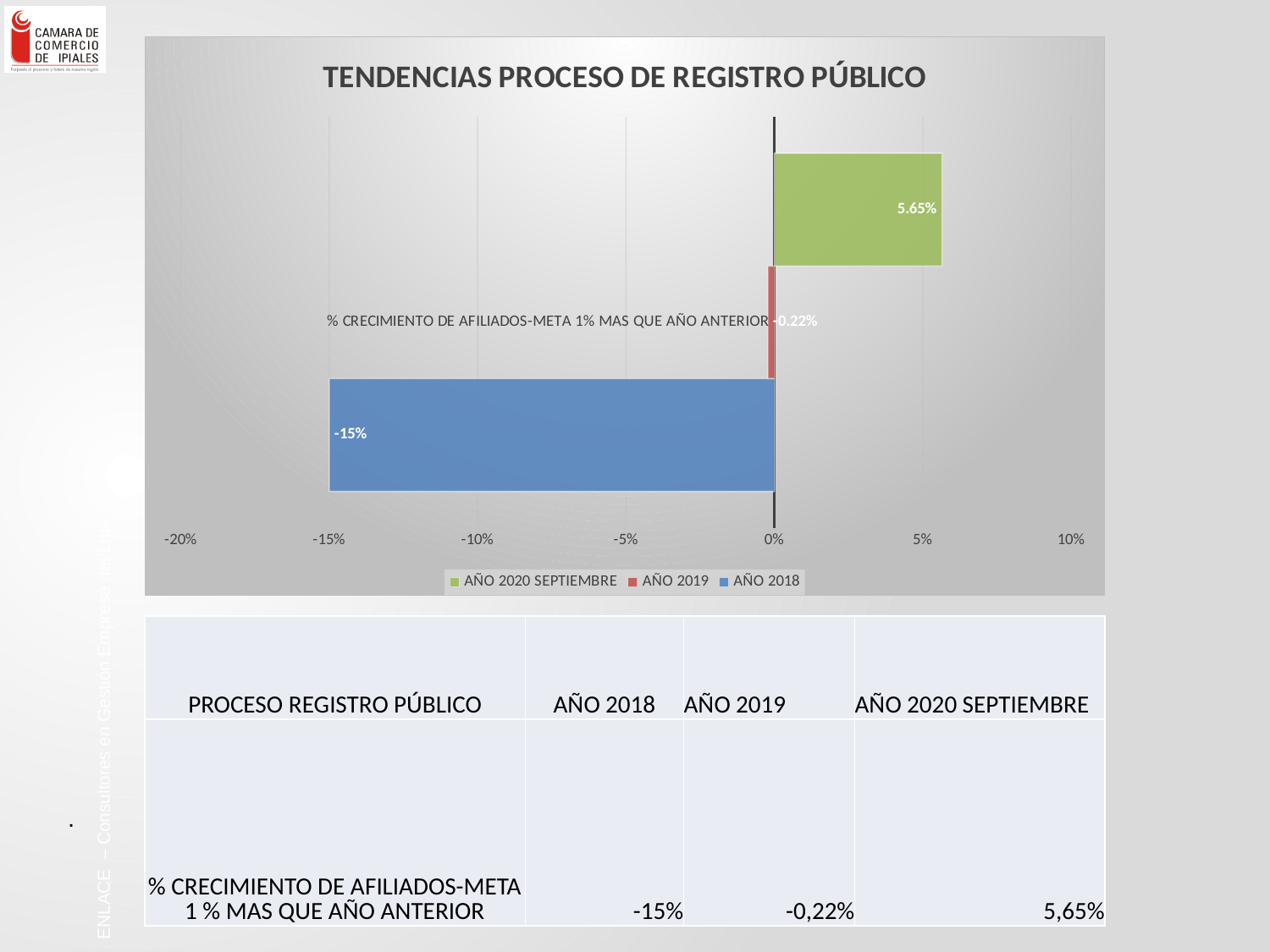
Is the value for AÑO 2018 greater or less than -10%? less Which is larger, the value for AÑO 2019 or the value for AÑO 2018? AÑO 2019 Which series has the lowest value in the chart? AÑO 2018 What is the title of the chart? TENDENCIAS PROCESO DE REGISTRO PÚBLICO What is the value for AÑO 2019 in the chart? -0.22% What is the difference between the value for AÑO 2020 SEPTIEMBRE and the value for AÑO 2018? 20.65% What is the value for AÑO 2020 SEPTIEMBRE in the chart? 5.65% What type of chart is shown on the slide? bar chart What is the value for AÑO 2018 in the chart? -15% Which series is shown in green in the chart? AÑO 2020 SEPTIEMBRE Which series has the highest value in the chart? AÑO 2020 SEPTIEMBRE How many series does the chart legend list? 3